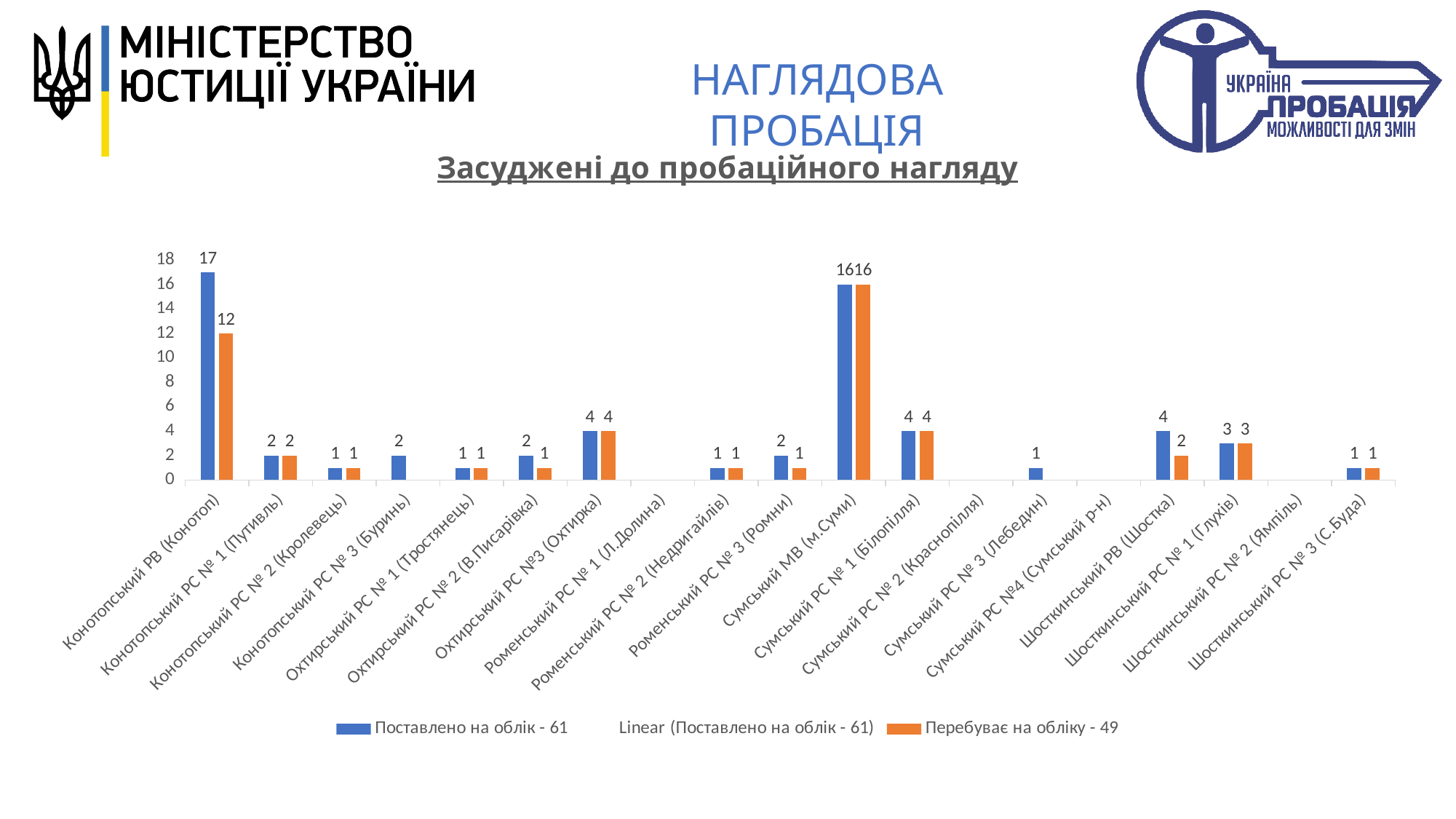
What is the difference between "Поставлено на облік - 61" and "Перебуває на обліку - 49" for Конотопський РВ (Конотоп)? 5 What is the value of "Перебуває на обліку - 49" for Конотопський РВ (Конотоп)? 12 How many categories are shown on the x axis of the chart? 19 Which is larger for Шосткинський РВ (Шостка): "Поставлено на облік - 61" or "Перебуває на обліку - 49"? Поставлено на облік - 61 How many entries does the chart legend list? 3 What is the value of "Поставлено на облік - 61" for Шосткинський РВ (Шостка)? 4 What is the title of the chart? Засуджені до пробаційного нагляду Which category has the highest value for "Поставлено на облік - 61"? Конотопський РВ (Конотоп) What is the value of "Перебуває на обліку - 49" for Сумський МВ (м.Суми)? 16 What is the value of "Поставлено на облік - 61" for Конотопський РВ (Конотоп)? 17 What type of chart is shown on the slide? bar chart Which category has the highest value for "Перебуває на обліку - 49"? Сумський МВ (м.Суми)